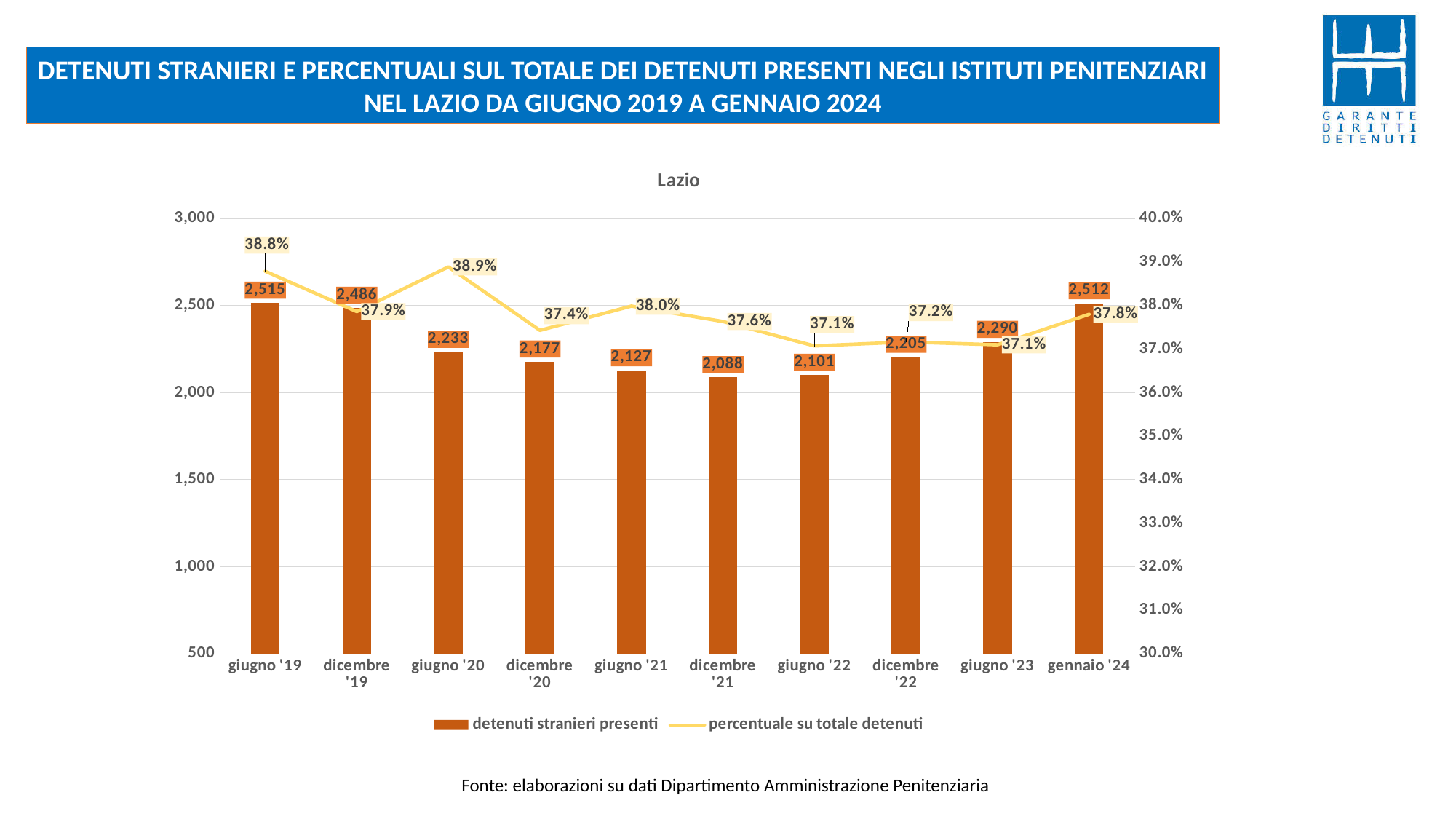
How many series does the legend list? 2 Which has more detenuti stranieri presenti, giugno '20 or giugno '22? giugno '20 What percentage of total detainees (percentuale su totale detenuti) is shown for giugno '20? 38.9% What is the value of detenuti stranieri presenti for dicembre '21? 2,088 How many time periods are shown on the x axis of the chart? 10 How many foreign detainees (detenuti stranieri presenti) were present in giugno '19? 2,515 What is the difference in detenuti stranieri presenti between giugno '23 and dicembre '22? 85 What is the percentuale su totale detenuti for gennaio '24? 37.8% What is the difference in detenuti stranieri presenti between giugno '19 and giugno '21? 388 What kind of chart is used to show detenuti stranieri presenti? bar chart Do the detenuti stranieri presenti values rise or fall from giugno '19 to dicembre '21? fall Is the percentuale su totale detenuti for dicembre '20 higher or lower than for giugno '21? lower